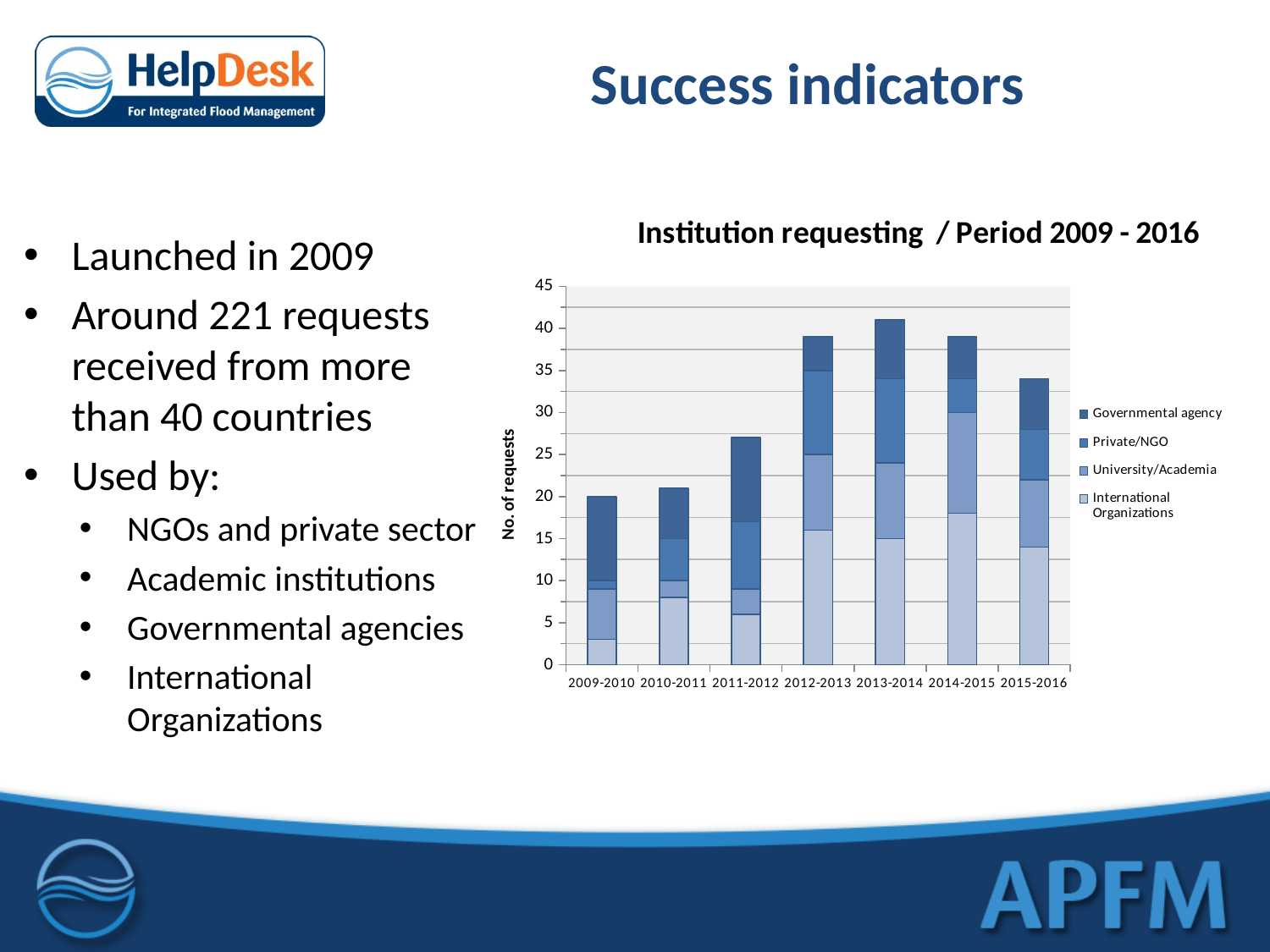
Which period has the highest total number of requests? 2013-2014 What kind of chart is shown on the slide? Stacked bar chart Is the total number of requests for 2011-2012 greater or less than 25? greater What is the label of the y axis of the chart? No. of requests What is the title of the chart? Institution requesting / Period 2009 - 2016 How many series does the chart legend list? 4 How many periods (categories) are shown on the x axis of the chart? 7 Is the total number of requests for 2015-2016 greater or less than 30? greater Is the total number of requests for 2010-2011 greater or less than 25? less How does the total number of requests change from 2009-2010 to 2013-2014? It rises Which period has a larger total number of requests, 2011-2012 or 2015-2016? 2015-2016